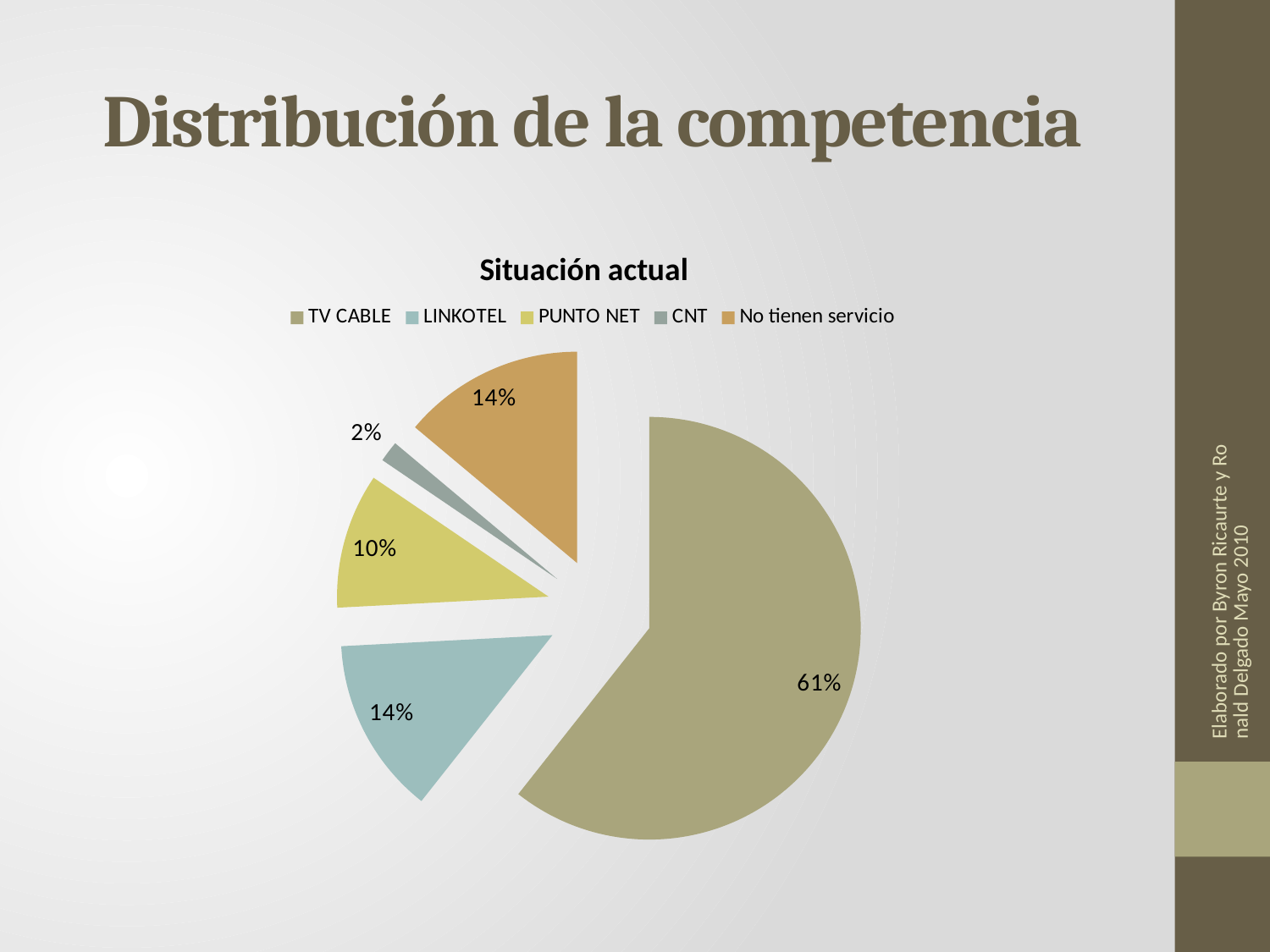
Which category has the largest slice of the pie? TV CABLE What is the difference in percentage points between TV CABLE and LINKOTEL? 47 What share of the pie does 'No tienen servicio' have? 14% What share of the pie does PUNTO NET have? 10% What type of chart is shown on the slide? Pie chart What share of the pie does LINKOTEL have? 14% Which category has the smallest slice of the pie? CNT What share of the pie does CNT have? 2% How many categories does the legend of the chart list? 5 What share of the pie does TV CABLE have? 61% Which is larger, the share for PUNTO NET or the share for CNT? PUNTO NET What is the title of the chart? Situación actual